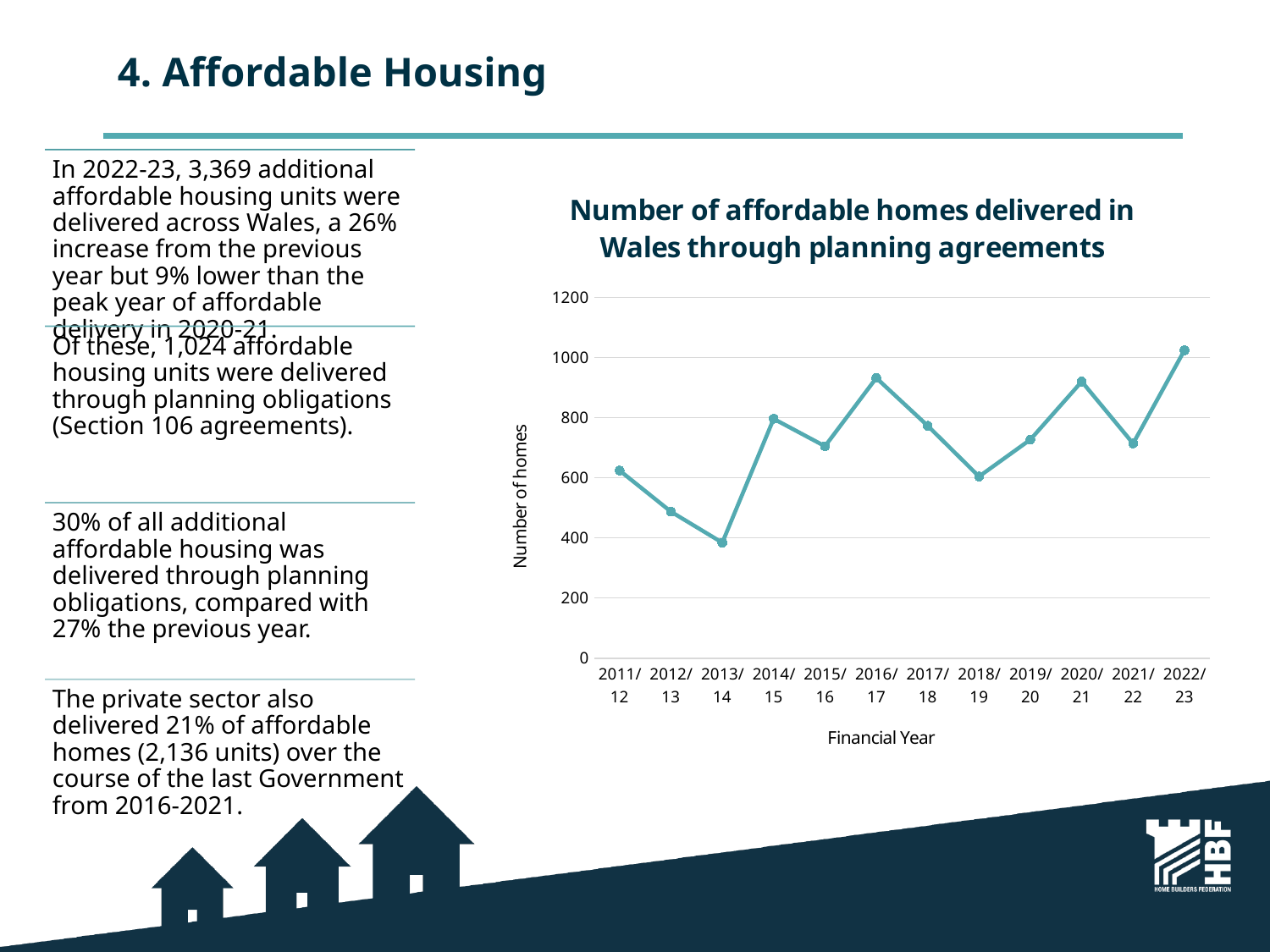
Is the value for 2016/17 greater or less than 800? greater How many financial years are plotted on the chart? 12 Which financial year has the lowest number of affordable homes delivered through planning agreements? 2013/14 What kind of chart is shown on the slide? line chart Which is larger, the value for 2016/17 or the value for 2012/13? 2016/17 Do the values rise or fall from 2011/12 to 2013/14? fall What is the label on the vertical axis of the chart? Number of homes Is the value for 2014/15 greater or less than 600? greater What is the title of the chart? Number of affordable homes delivered in Wales through planning agreements Which financial year has the highest number of affordable homes delivered through planning agreements? 2022/23 Is the value for 2012/13 greater or less than 600? less